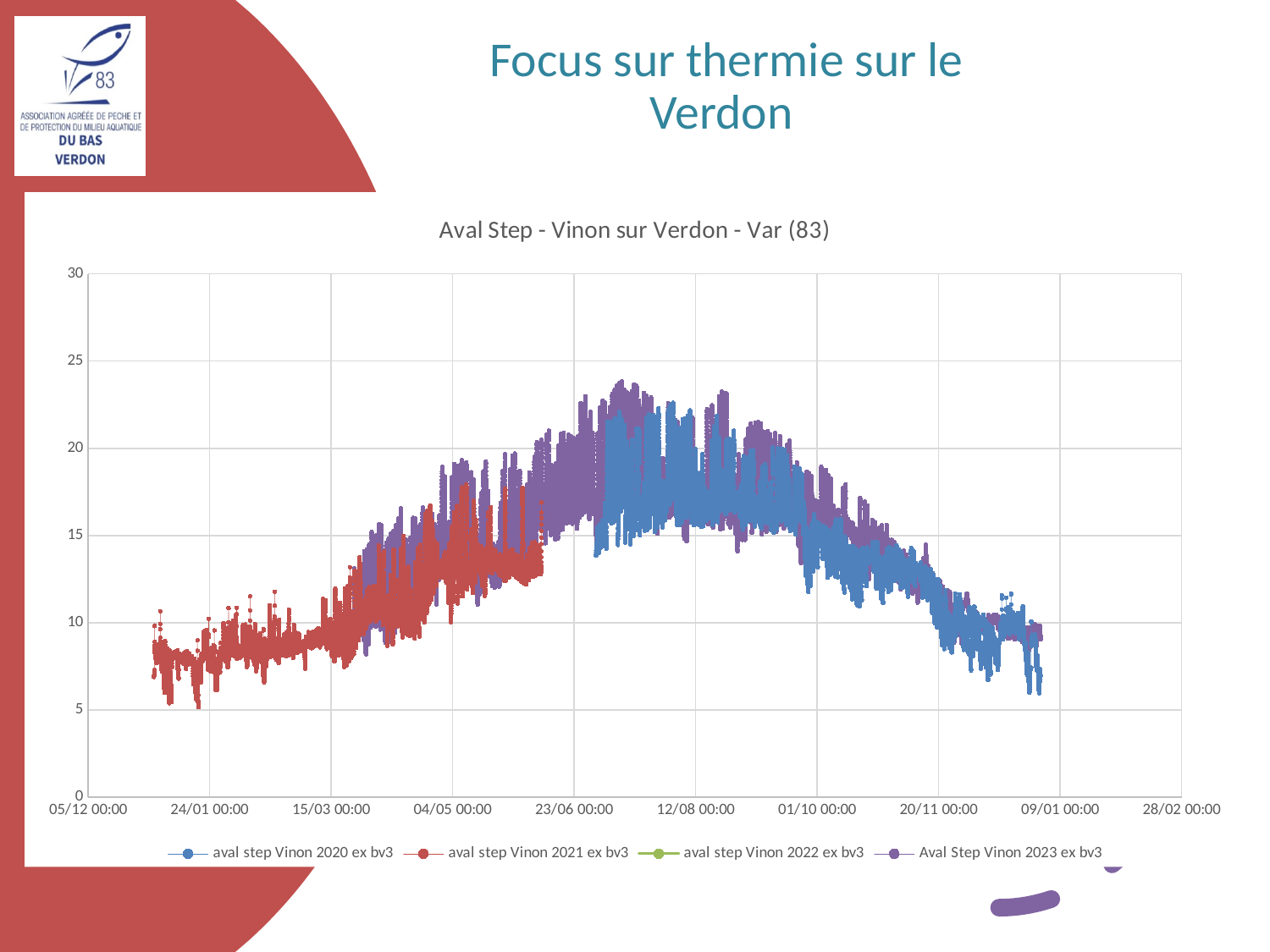
Are the values plotted around 12/08 00:00 greater or less than 15? greater How many series does the legend list? 4 Do the plotted values generally rise or fall between 24/01 00:00 and 12/08 00:00? rise What is the title of the chart? Aval Step - Vinon sur Verdon - Var (83) Are the values plotted around 12/08 00:00 greater or less than 10? greater Are the values plotted around 20/11 00:00 greater or less than 15? less Do the plotted values generally rise or fall between 12/08 00:00 and 09/01 00:00? fall What kind of chart is shown on the slide? line chart Which series is drawn in red in the legend? aval step Vinon 2021 ex bv3